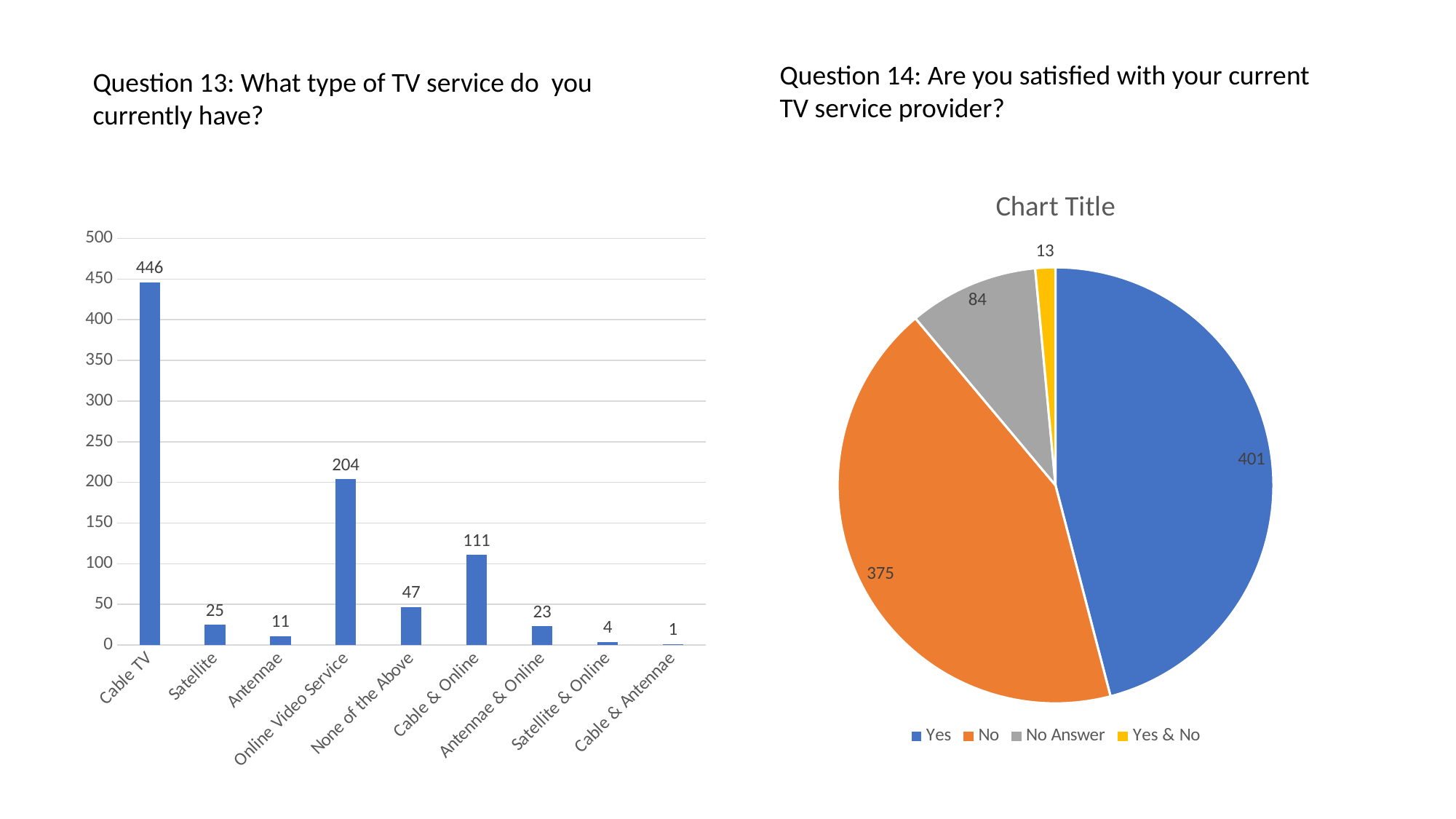
On the left bar chart (Question 13), what is the difference between Cable TV and Online Video Service? 242 On the left bar chart (Question 13), which category has the lowest value? Cable & Antennae On the left bar chart (Question 13), what is the value for Online Video Service? 204 On the right pie chart (Question 14), which slice is the largest? Yes On the left bar chart (Question 13), what is the value for Cable TV? 446 What kind of chart is the left chart (Question 13)? Bar chart On the right pie chart (Question 14), what is the value for No Answer? 84 On the left bar chart (Question 13), which category has the highest value? Cable TV On the right pie chart (Question 14), how many entries does the legend list? 4 On the right pie chart (Question 14), what is the difference between Yes and No? 26 On the left bar chart (Question 13), how many categories are shown on the x axis? 9 On the left bar chart (Question 13), which is larger: Satellite or Antennae & Online? Satellite